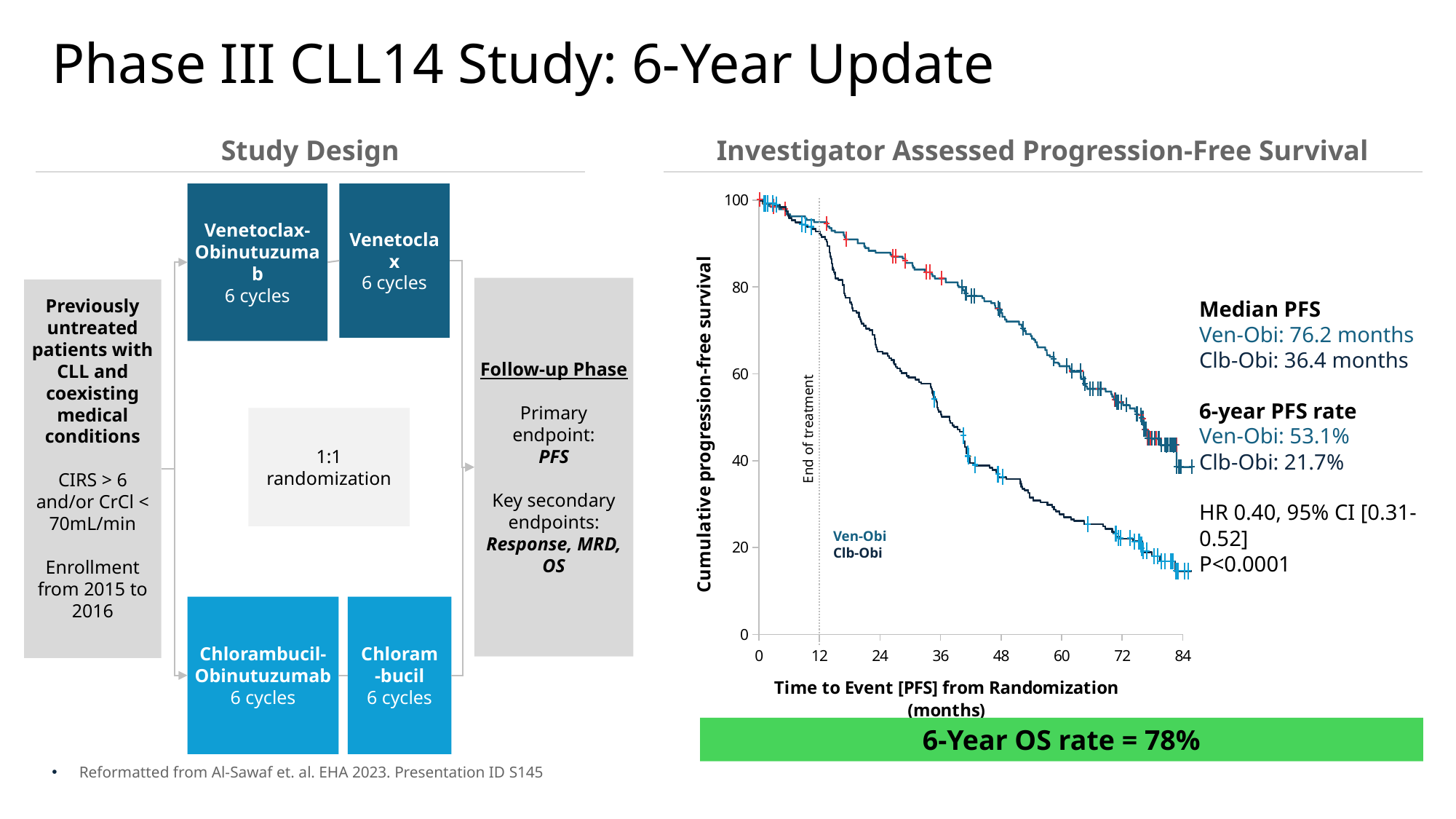
What is the 6-year PFS rate for the Ven-Obi arm? 53.1% What is the 6-year PFS rate for the Clb-Obi arm? 21.7% At 60 months, is the cumulative progression-free survival for the Clb-Obi arm greater or less than 40? less What is the title of the chart on the right side of the slide? Investigator Assessed Progression-Free Survival What is the median PFS for the Clb-Obi arm? 36.4 months Which arm has the higher 6-year PFS rate, Ven-Obi or Clb-Obi? Ven-Obi What is the median PFS for the Ven-Obi arm? 76.2 months What kind of chart is used to show progression-free survival? Line chart (Kaplan-Meier survival curve) What is the difference in median PFS between the Ven-Obi and Clb-Obi arms? 39.8 months Do the cumulative progression-free survival curves rise or fall as time from randomization increases? Fall How many series (treatment arms) are plotted in the progression-free survival chart? 2 What is the difference in 6-year PFS rate between the Ven-Obi and Clb-Obi arms? 31.4%